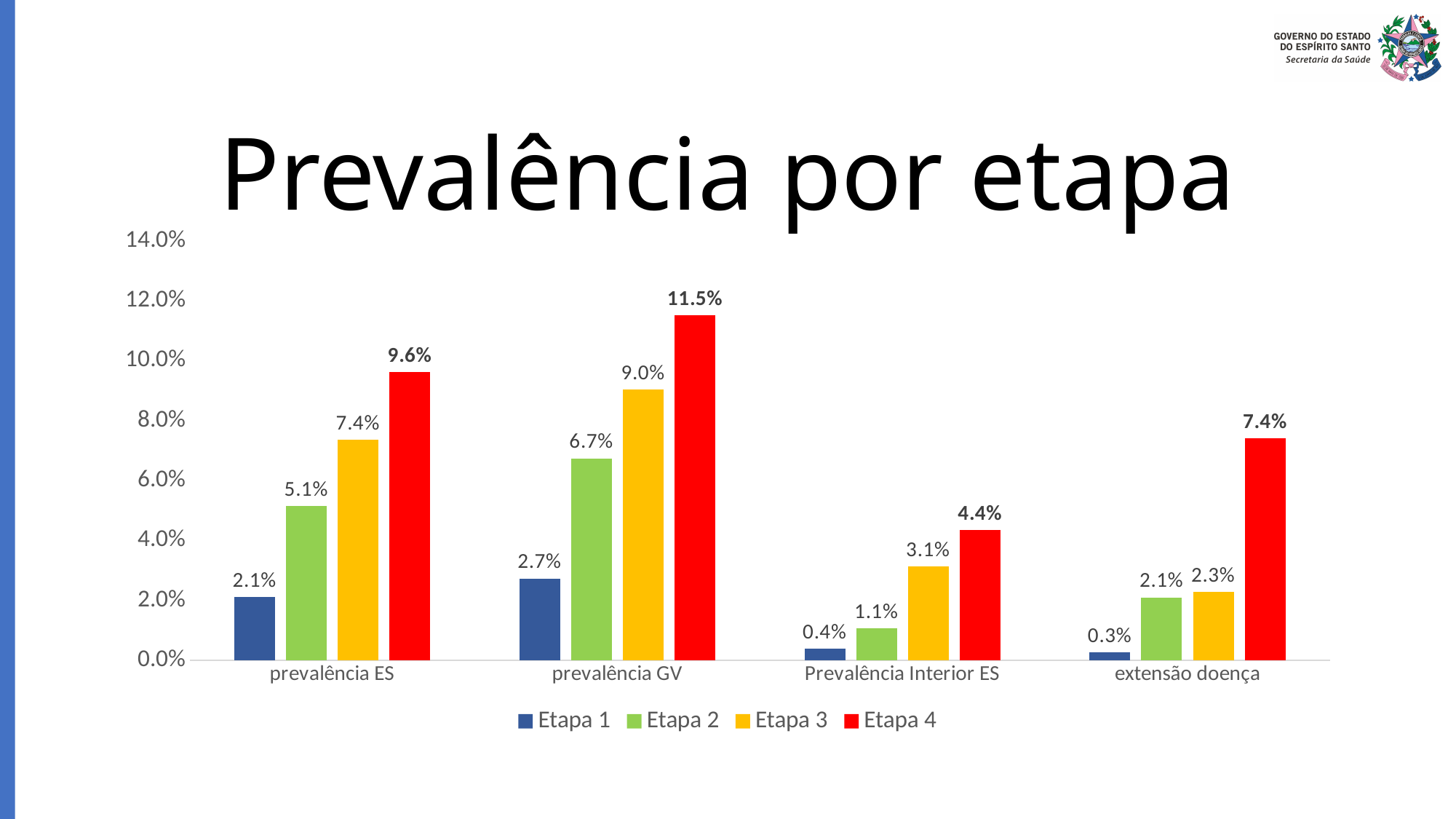
Which category has the lowest Etapa 1 value? extensão doença What is the value for Etapa 3 in the Prevalência Interior ES category? 3.1% What is the difference between the Etapa 4 and Etapa 3 values in the prevalência ES category? 2.2% What is the title of the slide? Prevalência por etapa Is the Etapa 4 value for prevalência GV greater or less than 10.0%? greater How many categories are shown on the x axis? 4 What kind of chart is shown on the slide? bar chart What is the value for Etapa 4 in the prevalência GV category? 11.5% What is the value for Etapa 1 in the extensão doença category? 0.3% Which category has the highest Etapa 4 value? prevalência GV Which is larger: the Etapa 2 value for prevalência GV or the Etapa 2 value for prevalência ES? prevalência GV How many series does the legend list? 4